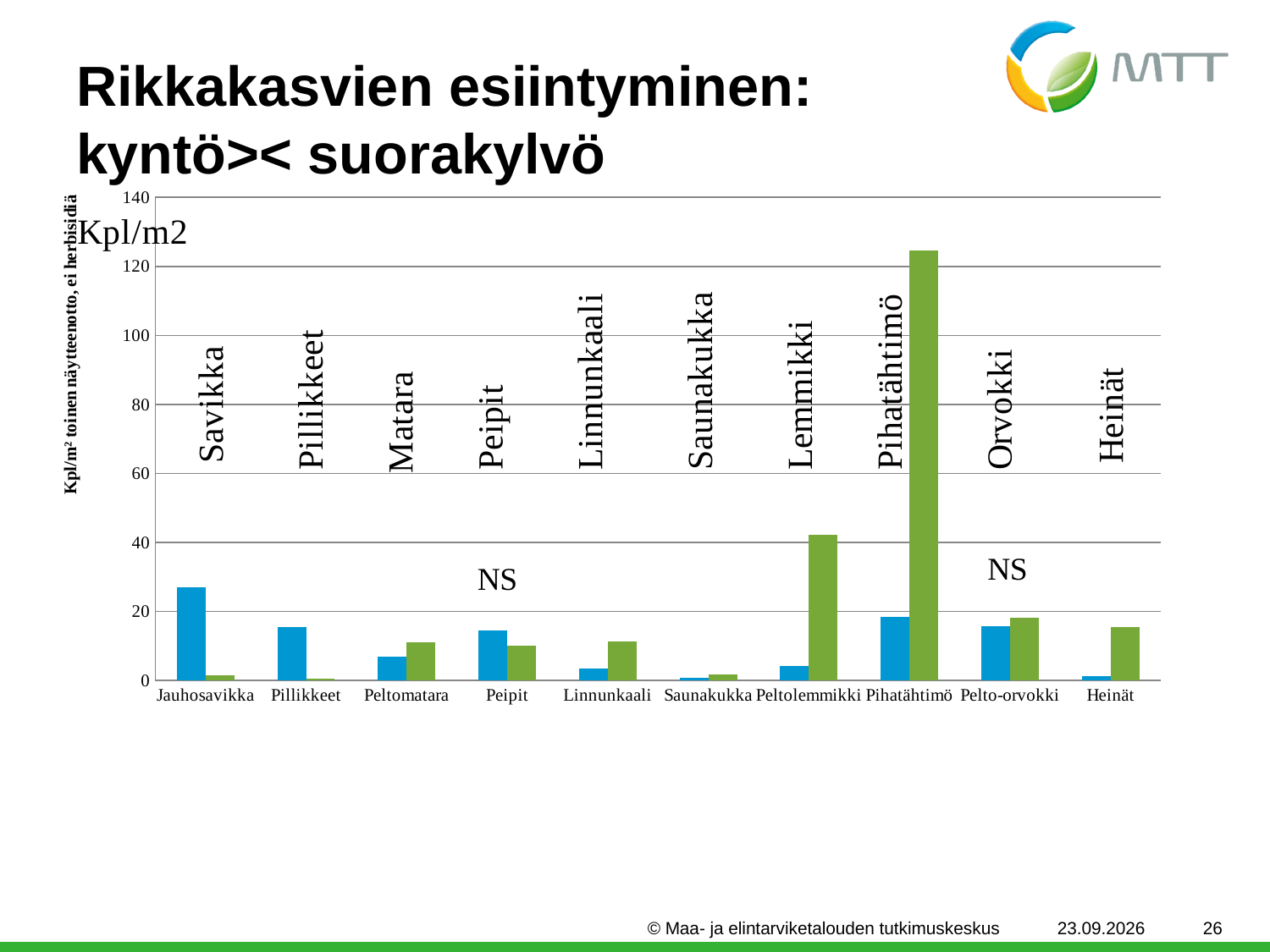
Is the blue bar for Jauhosavikka greater or less than 20? greater How many weed categories are shown along the x axis of the chart? 10 Which category has the tallest green bar in the chart? Pihatähtimö Which category has the tallest blue bar in the chart? Jauhosavikka What kind of chart is shown on the slide? bar chart For Jauhosavikka, which bar is taller, the blue one or the green one? the blue one For Heinät, which bar is taller, the blue one or the green one? the green one Is the green bar for Pihatähtimö greater or less than 120? greater What unit label is printed at the top left of the plot area? Kpl/m2 What is the highest value shown on the y axis of the chart? 140 Is the blue bar for Pihatähtimö greater or less than 20? less